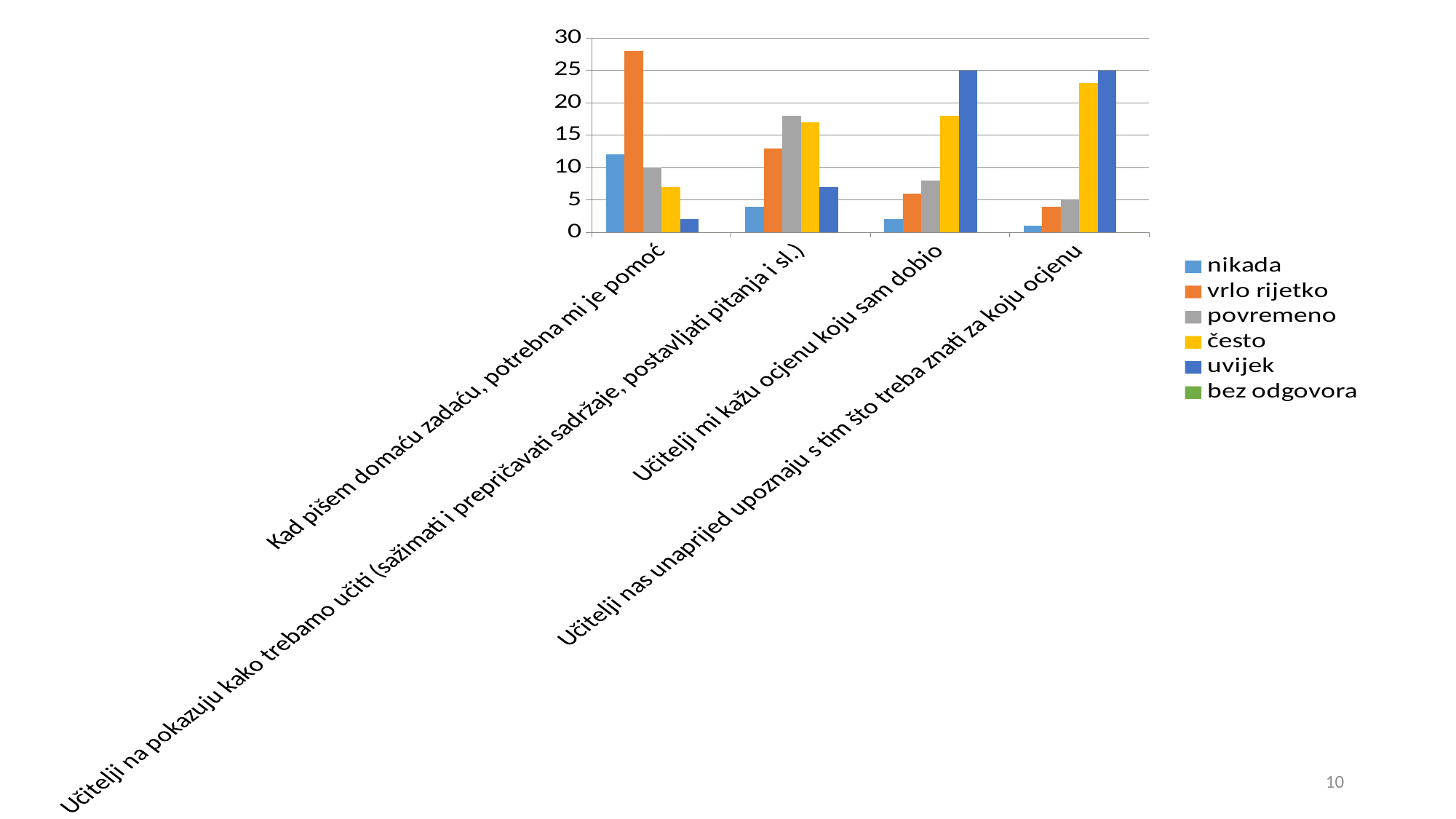
Which series has the highest value for the category 'Učitelji mi kažu ocjenu koju sam dobio'? uvijek Which series has the highest value for the category 'Kad pišem domaću zadaću, potrebna mi je pomoć'? vrlo rijetko Which is larger for 'Učitelji mi kažu ocjenu koju sam dobio': the 'često' value or the 'uvijek' value? uvijek Is the value of 'često' for 'Učitelji nas unaprijed upoznaju s tim što treba znati za koju ocjenu' greater or less than 20? greater Is the value of 'vrlo rijetko' for 'Kad pišem domaću zadaću, potrebna mi je pomoć' greater or less than 25? greater Which series has the lowest value for the category 'Kad pišem domaću zadaću, potrebna mi je pomoć'? bez odgovora What kind of chart is shown on the slide? bar chart Which legend entry is shown in yellow? često Is the value of 'nikada' for 'Učitelji mi kažu ocjenu koju sam dobio' greater or less than 5? less Which is larger: the 'nikada' value for 'Kad pišem domaću zadaću, potrebna mi je pomoć' or the 'nikada' value for 'Učitelji na pokazuju kako trebamo učiti (sažimati i prepričavati sadržaje, postavljati pitanja i sl.)'? Kad pišem domaću zadaću, potrebna mi je pomoć How many categories are shown on the x axis of the chart? 4 How many series does the chart's legend list? 6